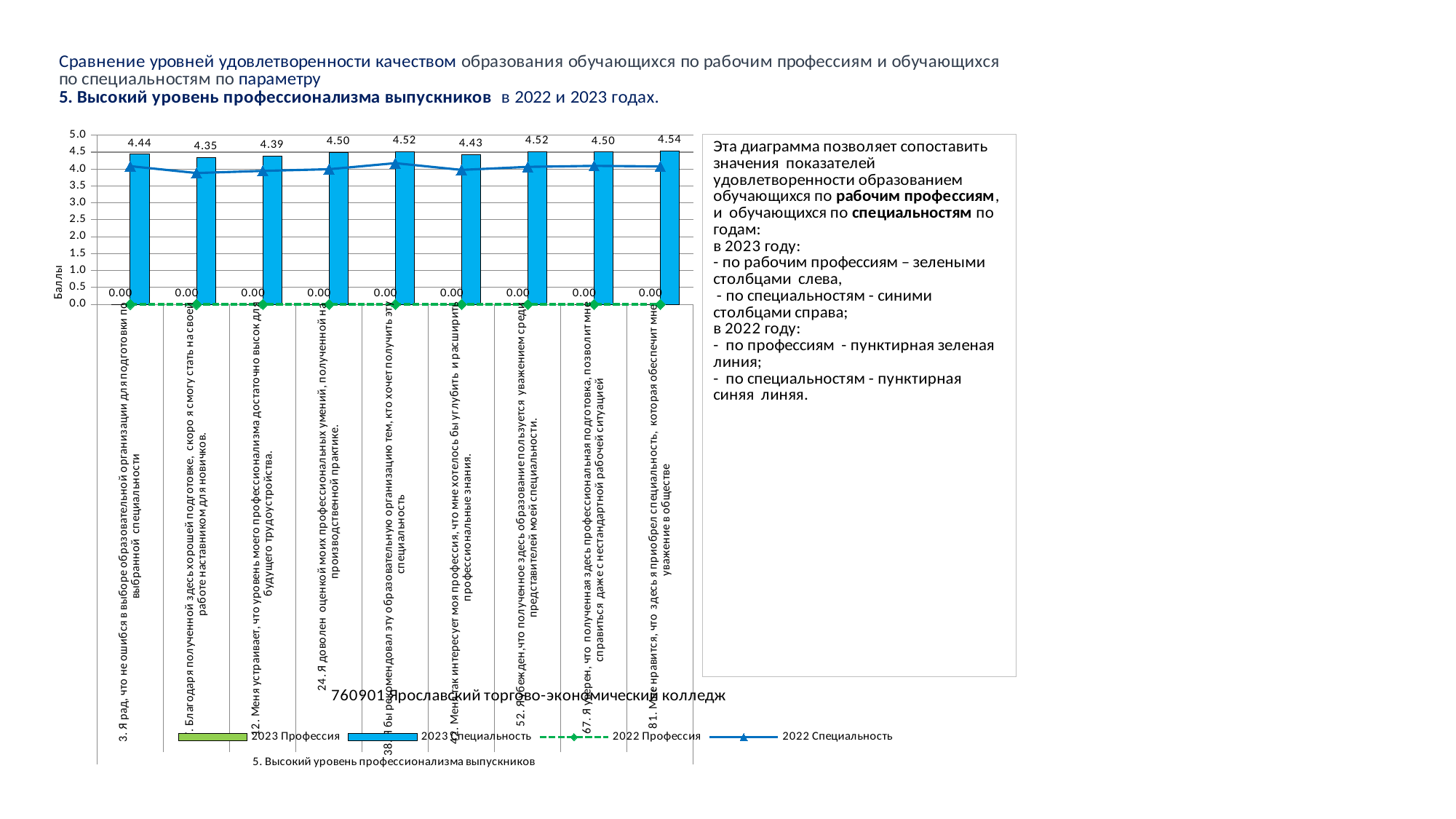
How many categories are shown on the x axis of the chart? 9 Which category has the highest 2023 Специальность value? 81. Мне нравится, что здесь я приобрел специальность, которая обеспечит мне уважение в обществе Which category has the lowest 2023 Специальность value? Благодаря полученной здесь хорошей подготовке, скоро я смогу стать в своей работе наставником для новичков What is the label of the vertical axis of the chart? Баллы What is the difference between the highest and lowest 2023 Специальность values? 0.19 What kind of chart is shown on the slide? Combined bar and line chart What is the 2023 Специальность value for the category "24. Я доволен оценкой моих профессиональных умений, полученной на производственной практике"? 4.50 How many series does the chart legend list? 4 What is the 2023 Специальность value for the category "3. Я рад, что не ошибся в выборе образовательной организации для подготовки по выбранной специальности"? 4.44 What is the 2023 Профессия value for the category "42. Меня так интересует моя профессия, что мне хотелось бы углубить и расширить профессиональные знания"? 0.00 Is the 2022 Специальность value for category 3 (Я рад, что не ошибся в выборе...) greater or less than 4.5? less